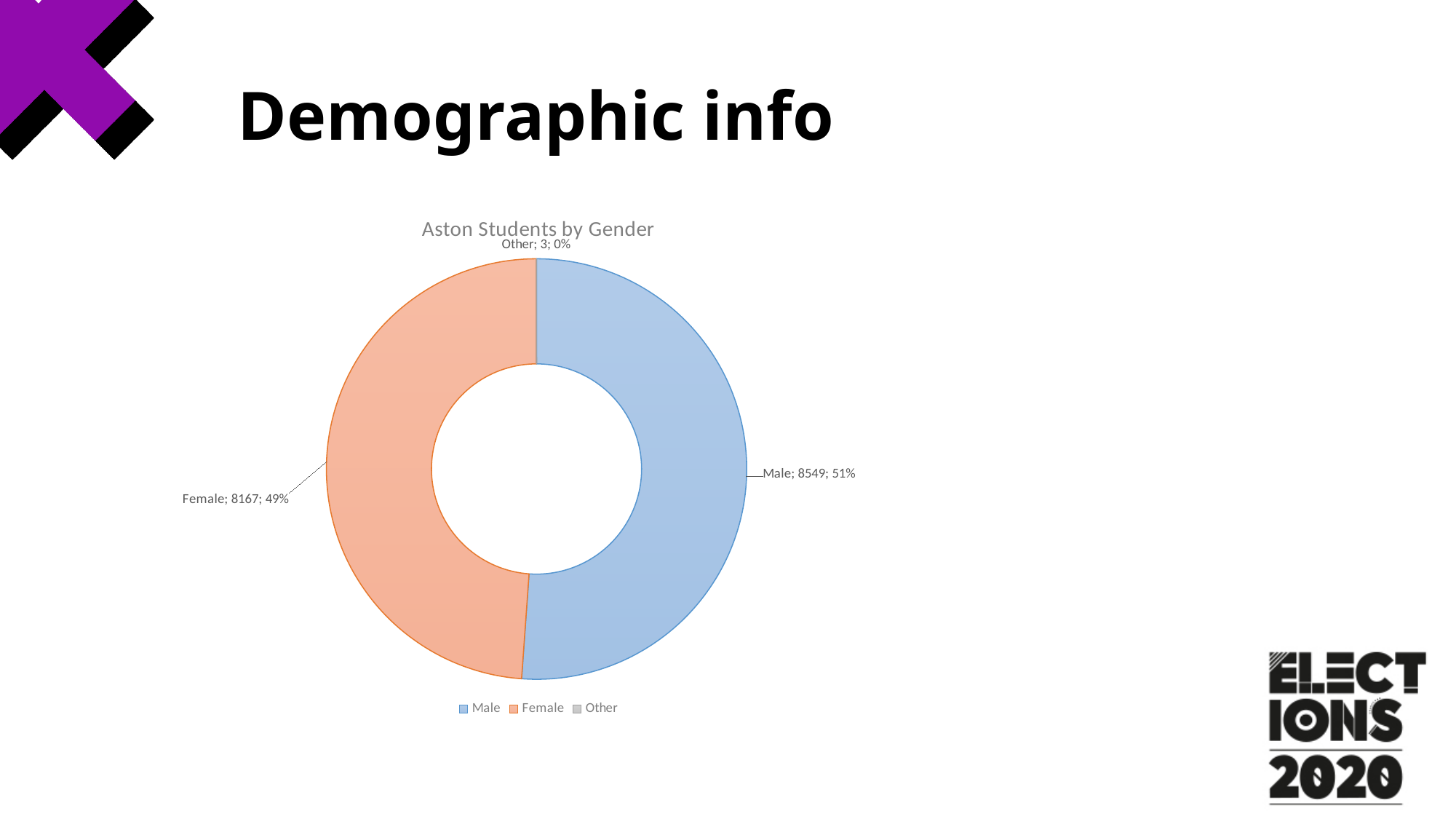
Which colour represents the Female category? Orange How many students are in the Other category? 3 Which category has the smallest number of students? Other What kind of chart is shown on the slide? Doughnut (pie) chart How many categories does the legend list? 3 What is the title of the chart? Aston Students by Gender Which category has the largest number of students? Male What share of the chart does the Female slice represent? 49% How many students are Male according to the chart? 8549 What share of the chart does the Male slice represent? 51% How many students are Female according to the chart? 8167 What is the difference between the number of Male and Female students? 382